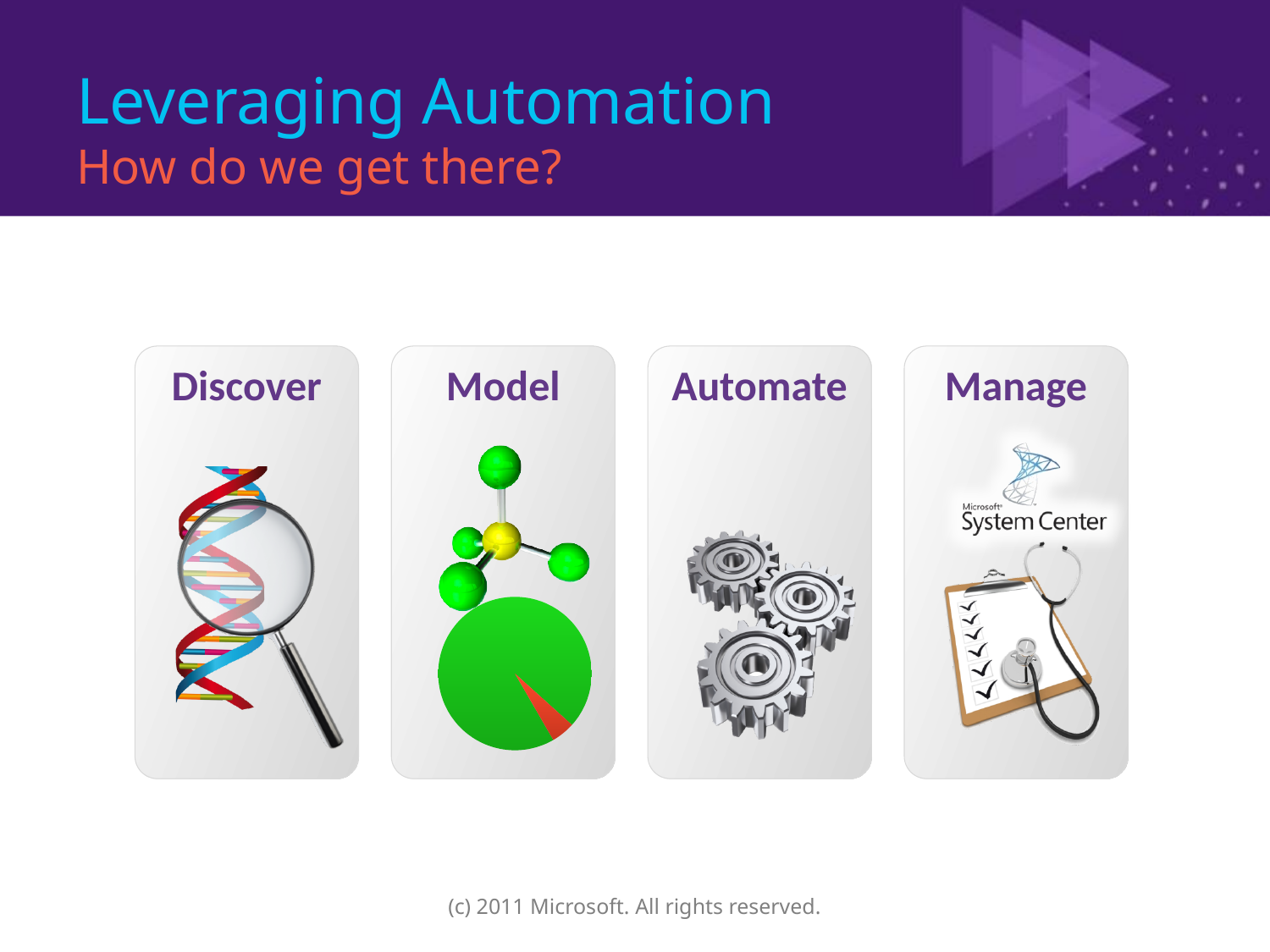
In the pie chart in the Model panel, which slice is larger, the green one or the red one? green In the pie chart in the Model panel, which slice is the smallest? the red slice What colour is the largest slice of the pie chart in the Model panel? green What kind of chart appears in the Model panel? pie chart How many slices does the pie chart in the Model panel have? 2